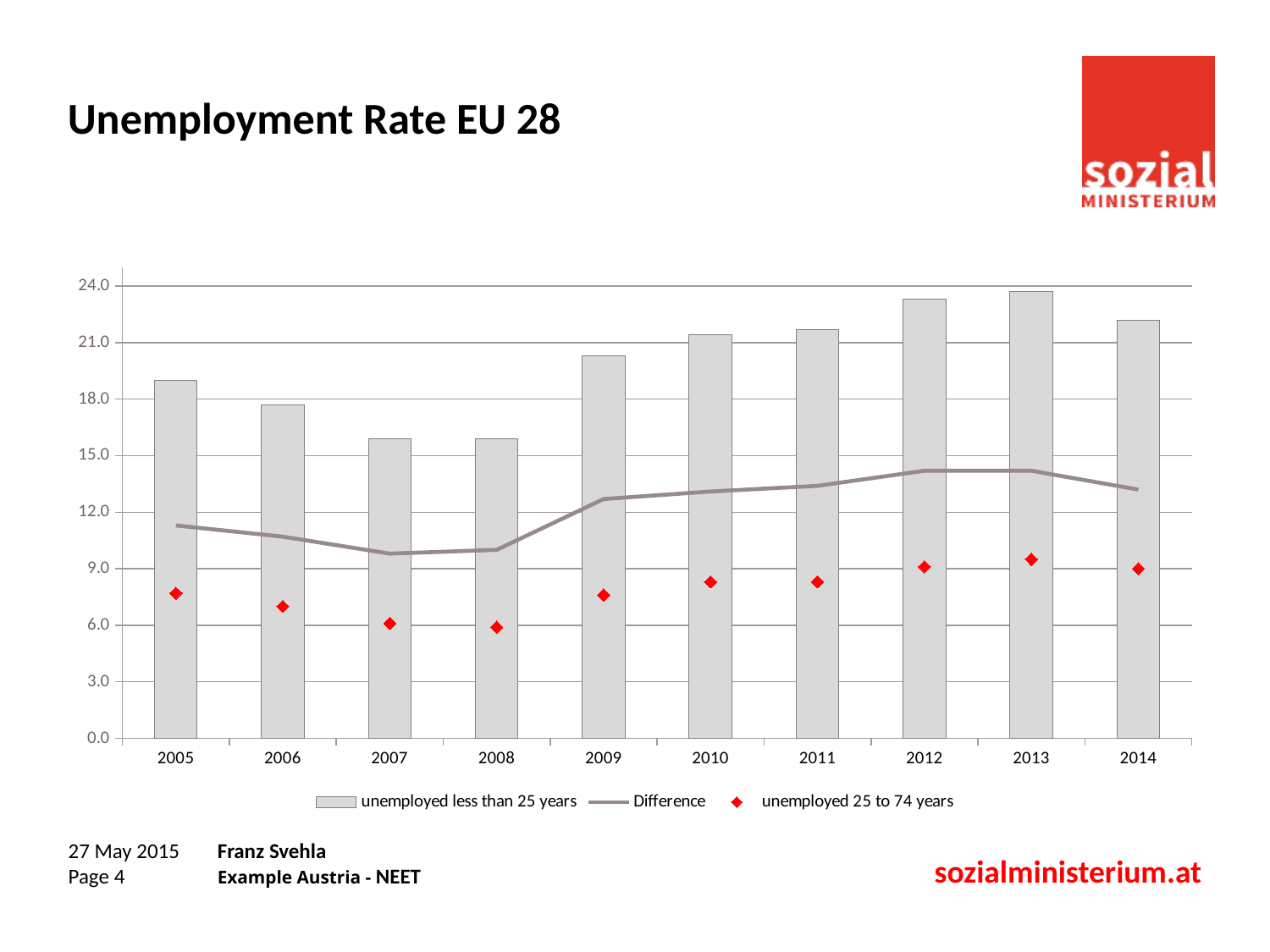
How many series does the legend list? 3 What is the title of the chart? Unemployment Rate EU 28 What kind of chart is shown on the slide? A combined bar and line chart Is the Difference value in 2014 greater or less than 12.0? greater Is the bar for unemployed less than 25 years in 2012 greater or less than 21.0? greater Is the bar for unemployed less than 25 years in 2005 greater or less than 18.0? greater Which is larger, the bar for unemployed less than 25 years in 2010 or in 2006? 2010 How many years are shown on the x axis? 10 Do the values for unemployed 25 to 74 years rise or fall from 2005 to 2008? fall Which year has the highest bar for unemployed less than 25 years? 2013